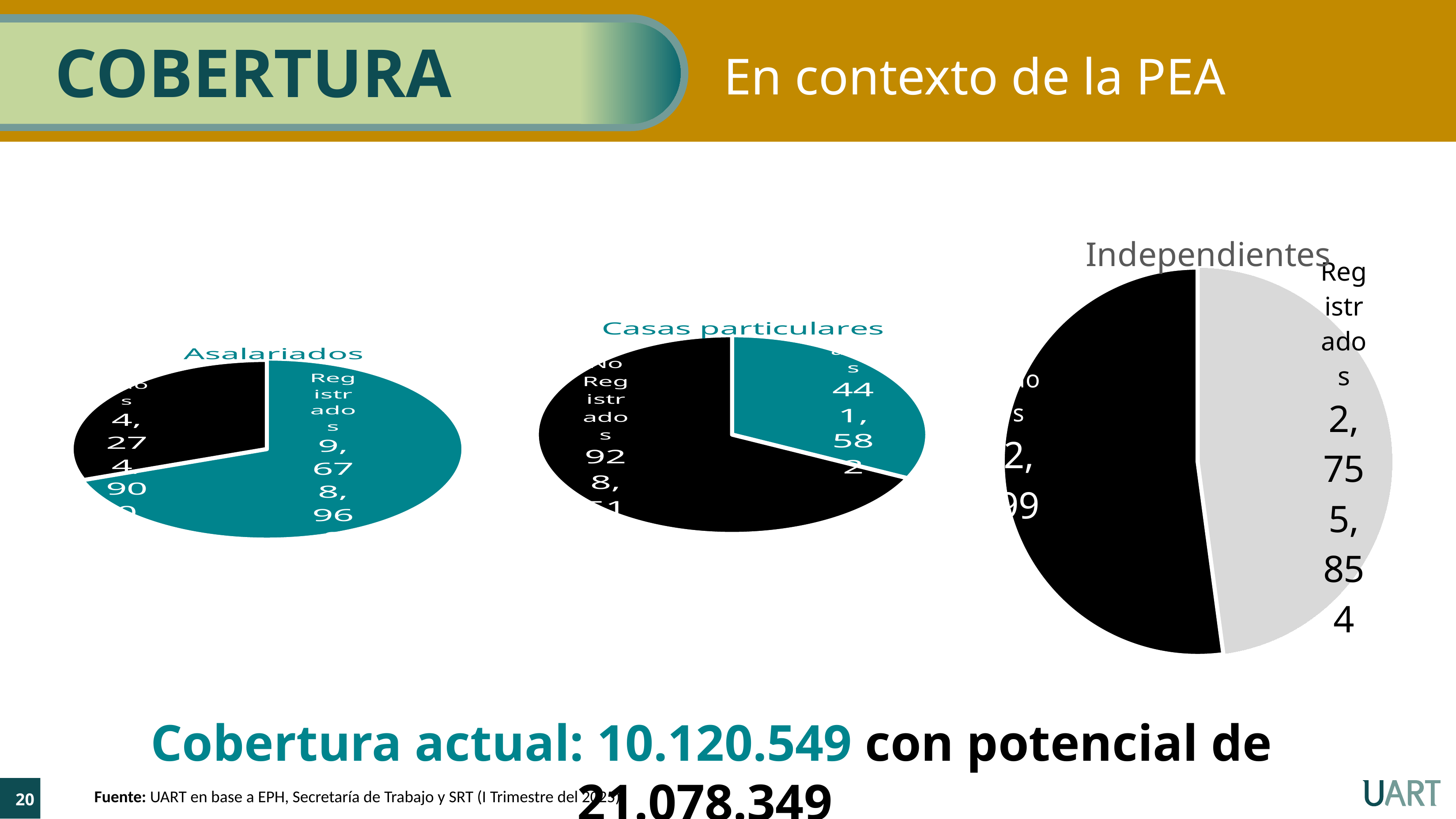
In the 'Asalariados' chart, which category has the largest slice? Registrados What colour is the Registrados slice in the 'Casas particulares' chart? teal What kind of chart is the 'Asalariados' chart? pie chart What kind of chart is the 'Independientes' chart? pie chart How many slices does the 'Casas particulares' pie chart have? 2 What is the title of the rightmost pie chart? Independientes How many pie charts are shown on the slide? 3 In the 'Casas particulares' chart, what is the value for Registrados? 441,582 In the 'Asalariados' chart, which slice is larger, Registrados or No Registrados? Registrados In the 'Independientes' chart, what is the value for Registrados? 2,755,854 In the 'Casas particulares' chart, which slice is larger, Registrados or No Registrados? No Registrados In the 'Casas particulares' chart, which category has the smallest slice? Registrados